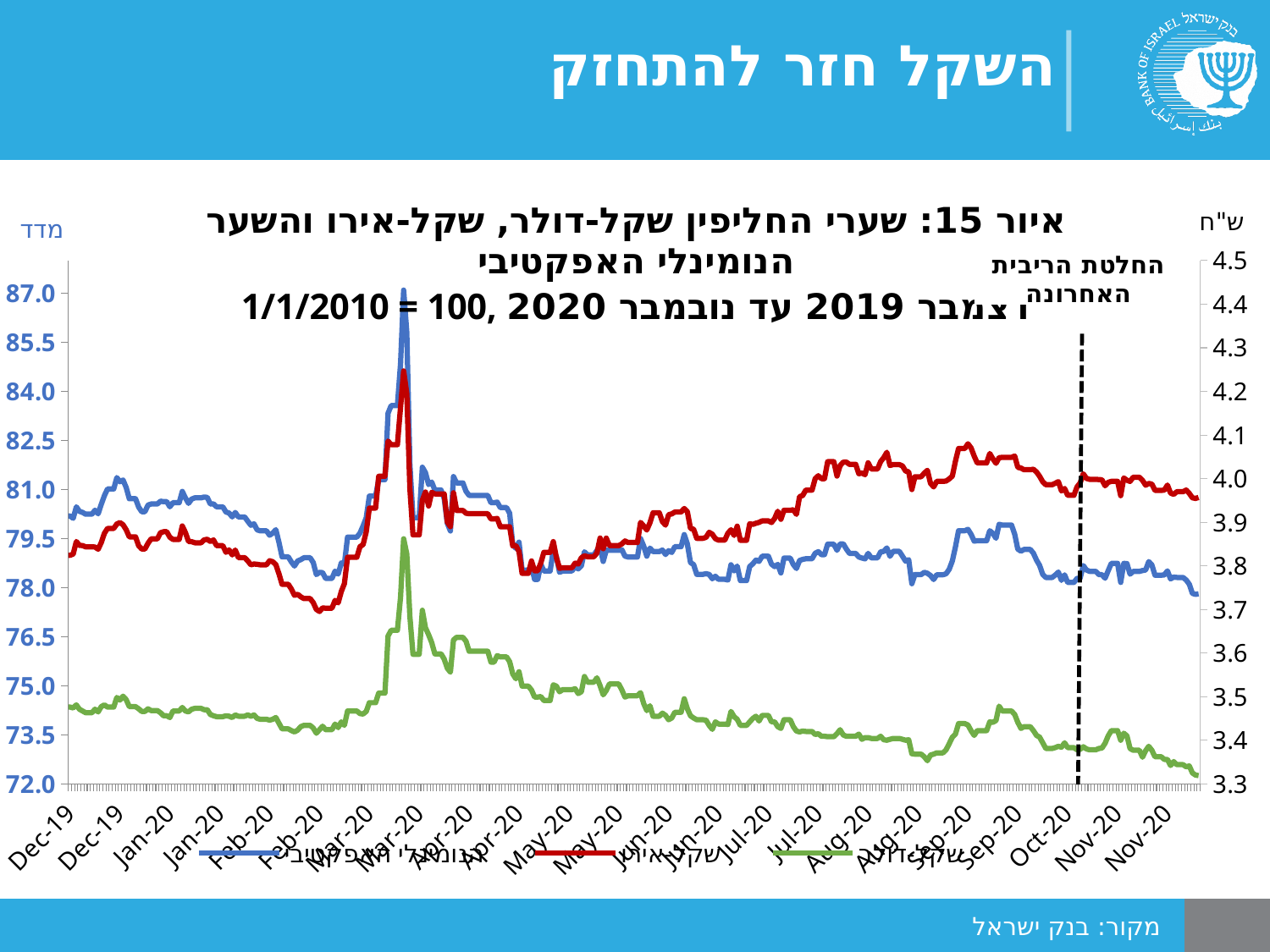
What base value does the chart title state for the index (1/1/2010 = ?)? 100 What is the figure number given in the chart title? איור 15 Does the green line rise or fall from Sep-20 to Nov-20? fall How many series does the legend list? 3 Is the peak of the blue line in Mar-20 greater or less than 85.5 on the left axis? greater Is the value of the green line at the end of the series (Nov-20) greater or less than 3.4 on the right axis? less Is the peak of the red line in Mar-20 greater or less than 4.2 on the right axis? greater What kind of chart is shown on the slide? line chart Which line is higher on the right axis in Nov-20, the red line or the green line? the red line Does the blue line rise or fall from its Mar-20 peak to Nov-20? fall